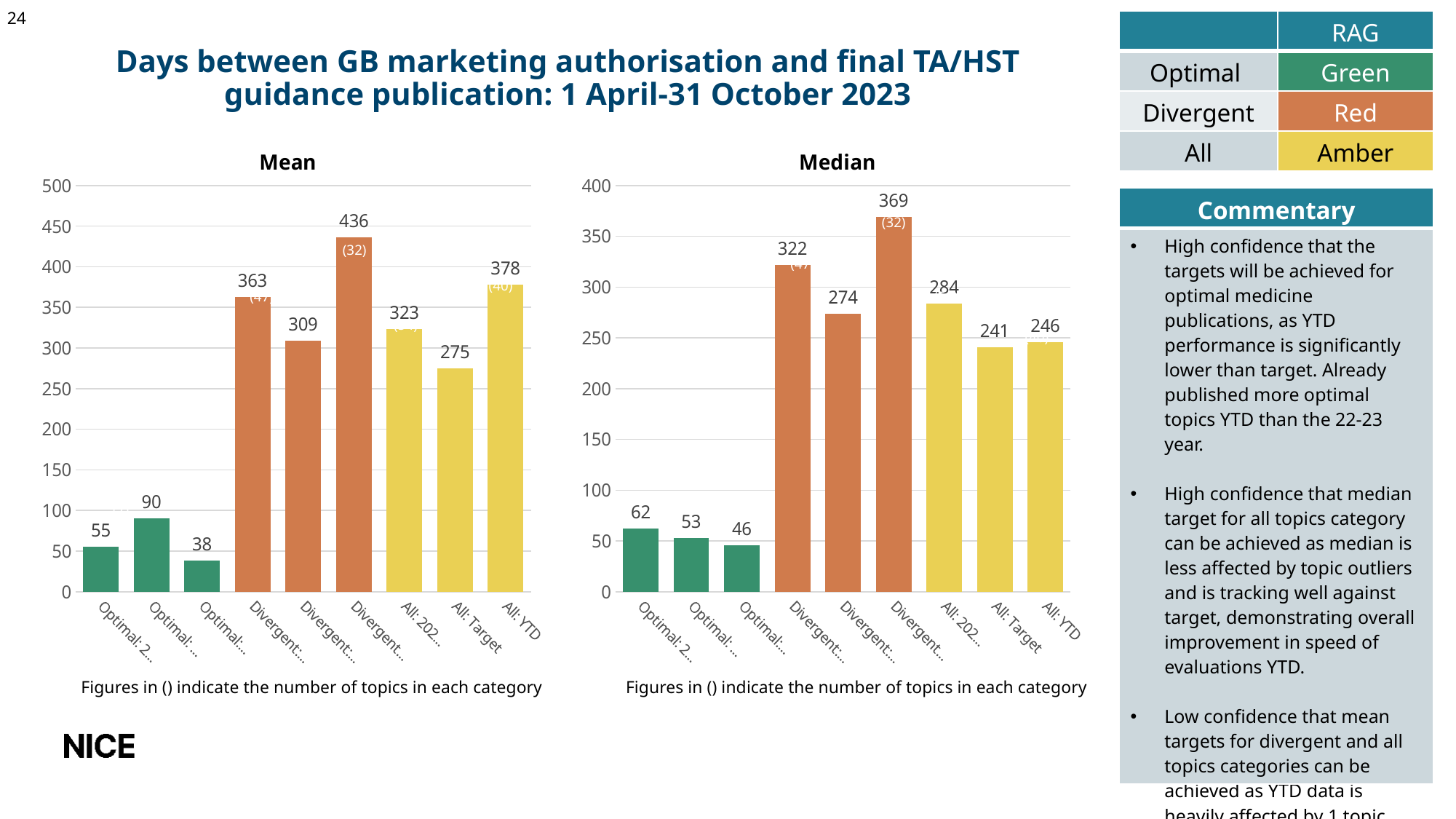
What kind of chart is the Mean chart? Bar chart On the Median chart, what is the value for All: YTD? 246 On the Median chart, what is the lowest value shown on any bar? 46 On the Mean chart, what is the value for All: Target? 275 On the Median chart, what is the value for All: Target? 241 On the Mean chart, which is larger, All: YTD or All: Target? All: YTD On the Median chart, what is the highest value shown on any bar? 369 How many bars are plotted on the Median chart? 9 On the Mean chart, what is the difference between the values for All: YTD and All: Target? 103 On the Mean chart, what is the highest value shown on any bar? 436 On the Mean chart, what is the lowest value shown on any bar? 38 On the Mean chart, what is the value for All: YTD? 378